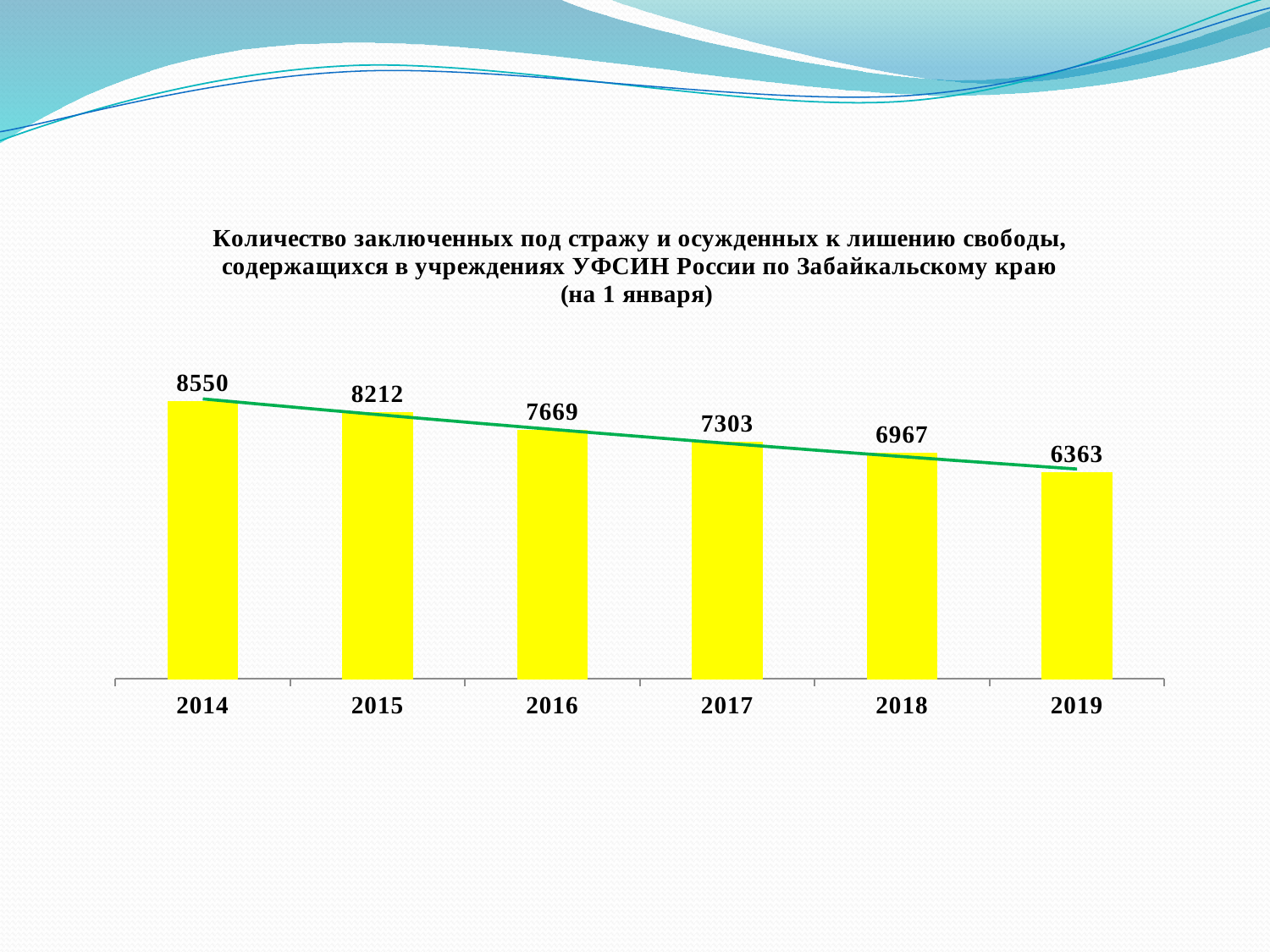
What is the difference between the values for 2014 and 2019? 2187 Which year has the lowest value? 2019 What is the difference between the values for 2015 and 2016? 543 What is the value for 2019? 6363 Which year has the highest value? 2014 What is the value for 2014? 8550 How many years are shown on the x axis? 6 What colour are the bars? yellow What kind of chart is this? bar chart Do the values rise or fall from 2014 to 2019? fall What is the value for 2017? 7303 Which is larger, the value for 2016 or the value for 2018? 2016